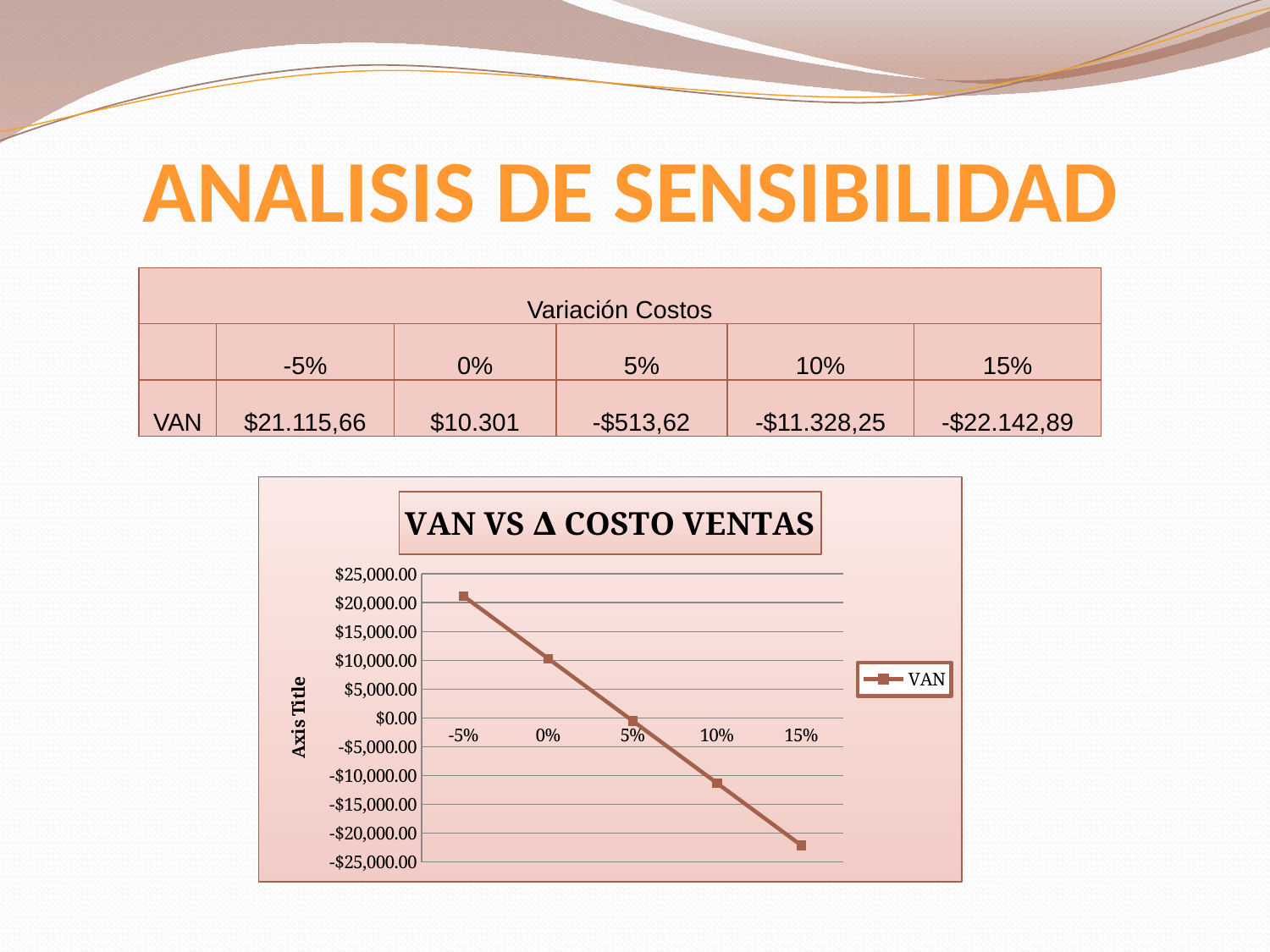
At which cost variation is VAN highest? -5% How many series does the chart legend list? 1 According to the table, what is the VAN at a 10% cost variation? -$11.328,25 What type of chart is shown on the slide? line chart Which is larger, the VAN at 5% or the VAN at 10%? 5% According to the table, what is the VAN at a 0% cost variation? $10.301 At which cost variation is VAN lowest? 15% Does the VAN value rise or fall as the cost variation increases along the x axis? fall Is the VAN value at 15% greater or less than -$20,000.00? less Is the VAN value at -5% greater or less than $20,000.00? greater What is the title of the chart? VAN VS Δ COSTO VENTAS How many data points are plotted on the VAN line? 5